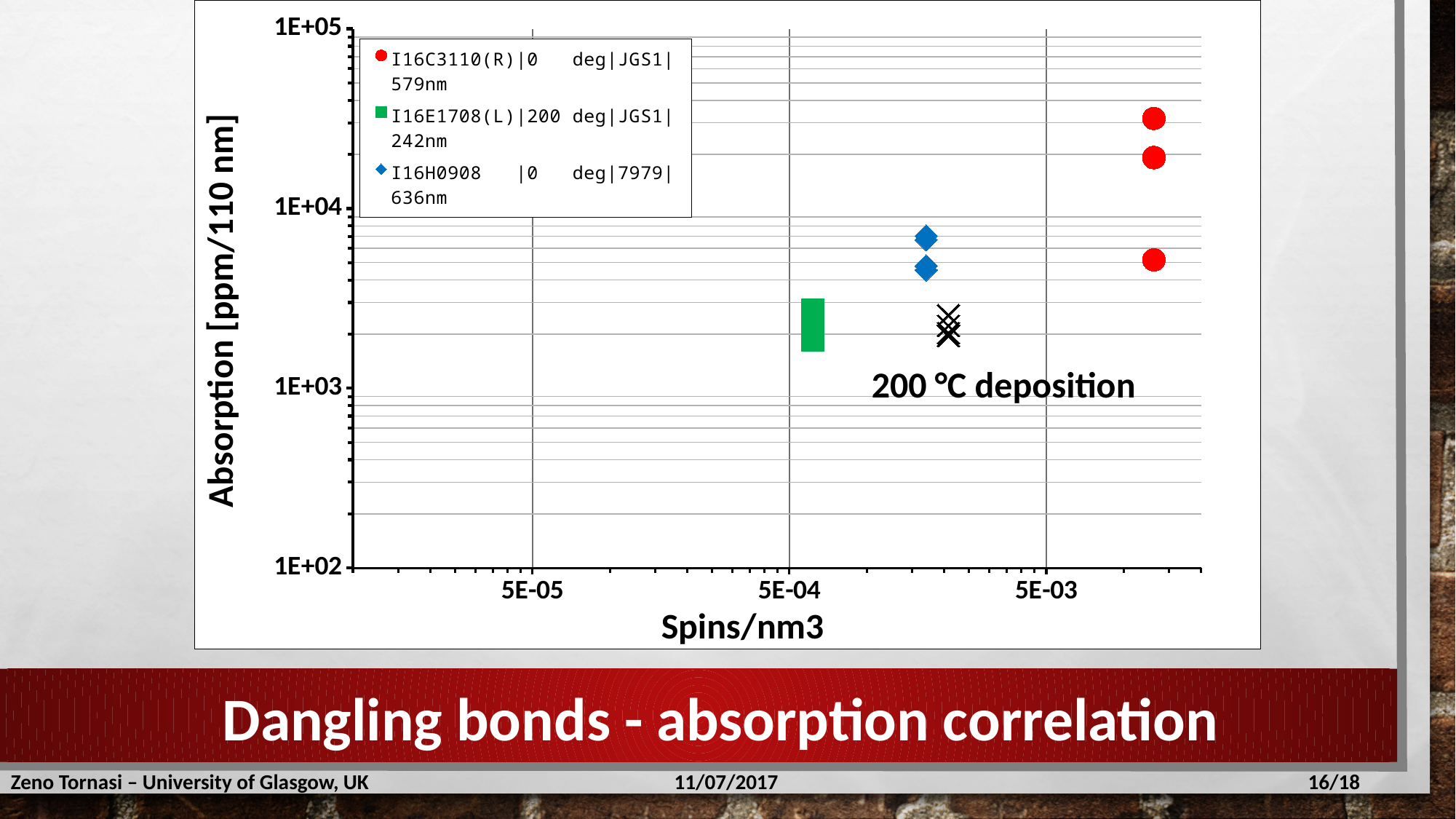
Which series is plotted at the lowest Spins/nm3 values? I16E1708(L)|200 deg|JGS1|242nm How many series does the legend list? 3 What is the label of the y axis? Absorption [ppm/110 nm] What kind of chart is shown on the slide? scatter chart Which series has larger absorption values, I16H0908 or I16E1708(L)? I16H0908 What is the label of the x axis? Spins/nm3 Is the highest absorption value for the I16C3110(R) series greater or less than 1E+04? greater Are the absorption values for the I16H0908 series greater or less than 1E+04? less Are the absorption values for the I16E1708(L) series greater or less than 1E+03? greater Which series has the highest absorption values? I16C3110(R)|0 deg|JGS1|579nm Does absorption generally rise or fall as Spins/nm3 increases? rise